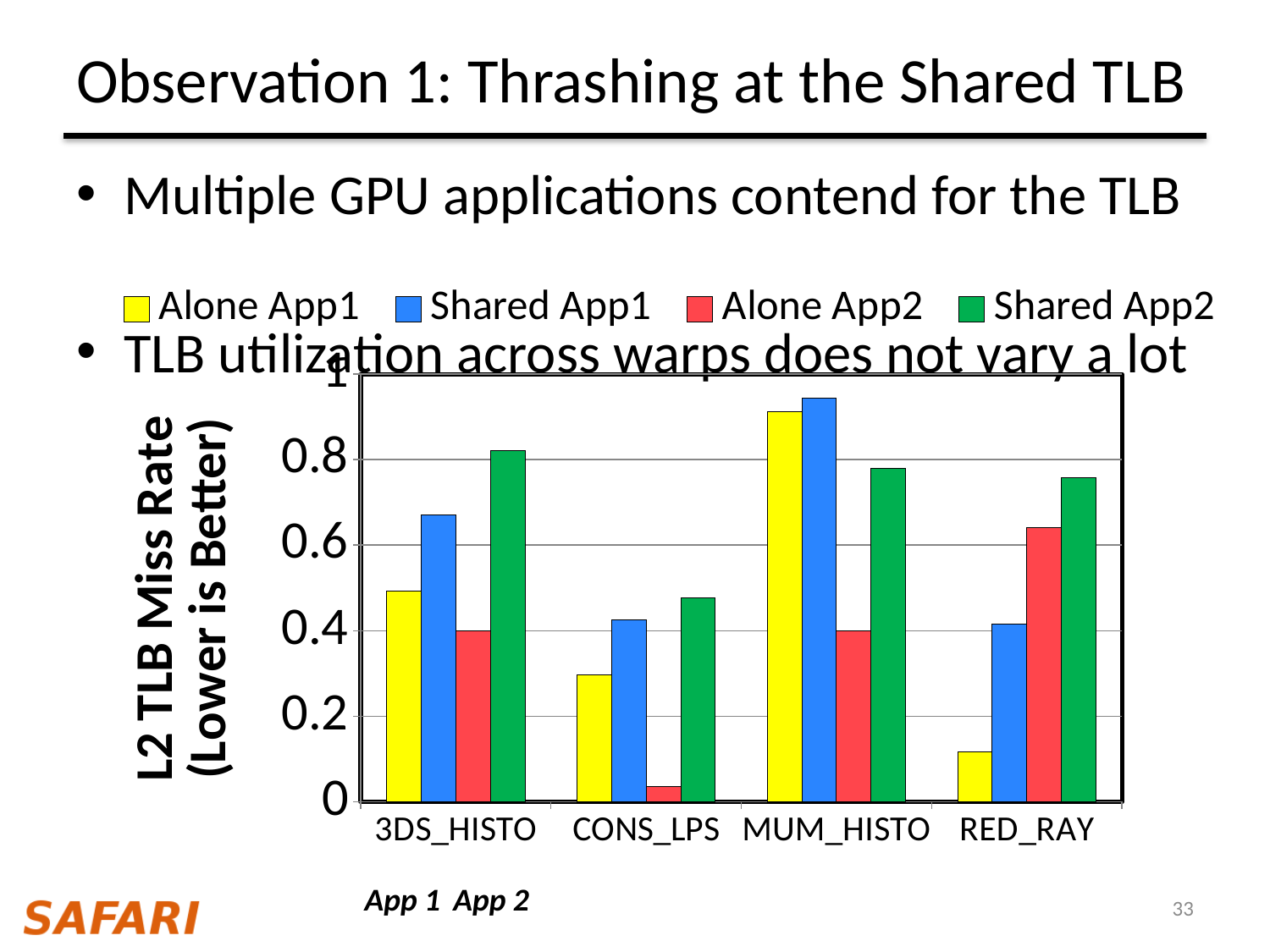
How many series does the legend list? 4 For 3DS_HISTO, which is larger: the Shared App1 or the Shared App2 miss rate? Shared App2 For which category is the Shared App1 L2 TLB miss rate highest? MUM_HISTO For RED_RAY, which is larger: the Alone App1 or the Alone App2 miss rate? Alone App2 What kind of chart is shown on the slide? bar chart Is the Alone App1 miss rate for MUM_HISTO greater or less than 0.8? greater Is the Shared App1 miss rate for 3DS_HISTO greater or less than 0.6? greater Is the Alone App1 miss rate for RED_RAY greater or less than 0.2? less What is the label of the y axis? L2 TLB Miss Rate (Lower is Better) How many application pairs (categories) are shown on the x axis? 4 For which category is the Alone App2 L2 TLB miss rate lowest? CONS_LPS